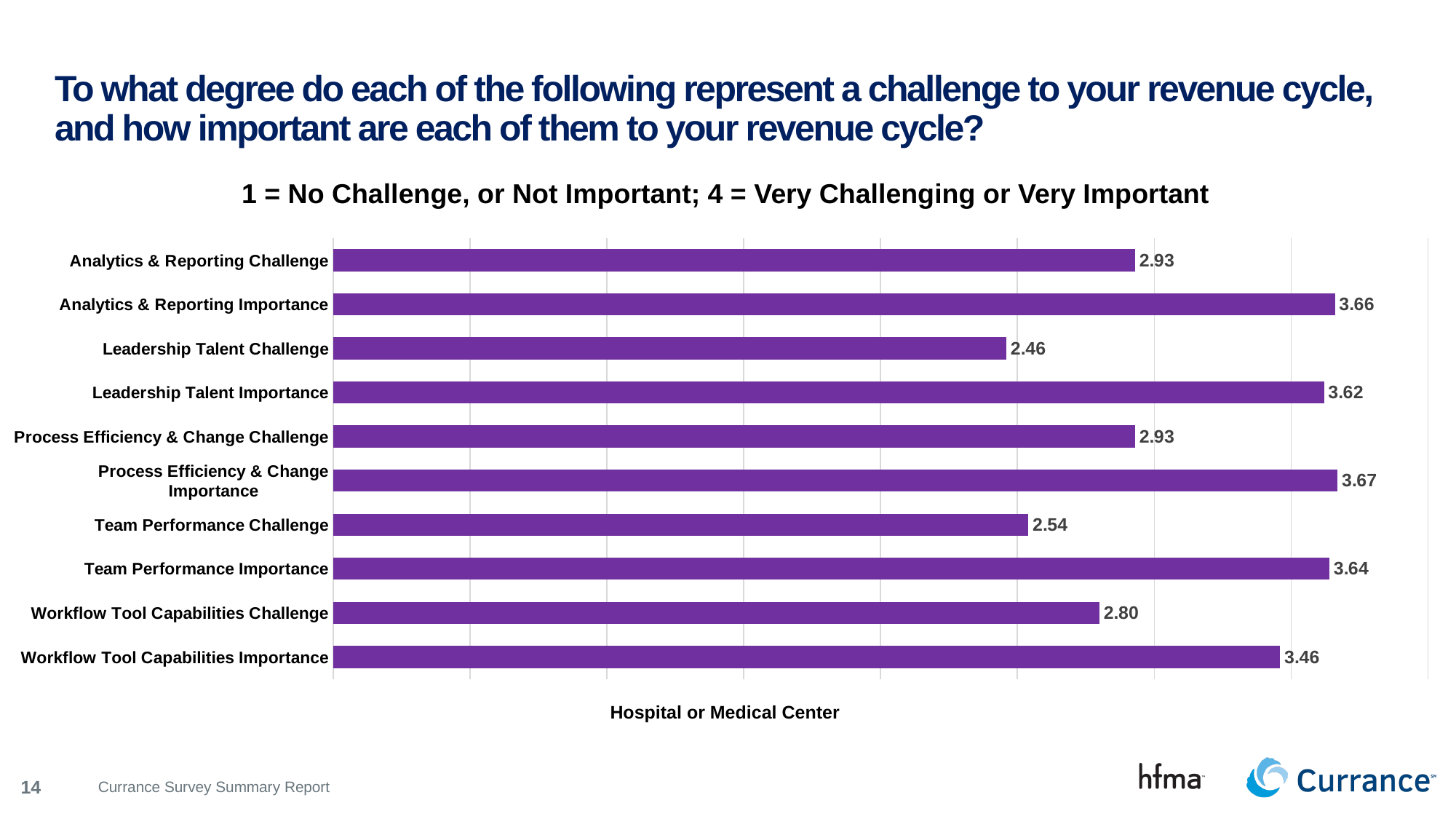
What is the value for Workflow Tool Capabilities Challenge? 2.80 Which category has the lowest value? Leadership Talent Challenge What is the difference between Analytics & Reporting Importance and Analytics & Reporting Challenge? 0.73 What is the value for Team Performance Importance? 3.64 What kind of chart is shown on the slide? Bar chart What is the value for Leadership Talent Challenge? 2.46 What is the difference between Team Performance Importance and Team Performance Challenge? 1.10 Which is larger, Workflow Tool Capabilities Importance or Leadership Talent Importance? Leadership Talent Importance How many categories are shown in the chart? 10 Which category has the highest value? Process Efficiency & Change Importance What is the label shown below the chart's horizontal axis? Hospital or Medical Center What is the value for Analytics & Reporting Importance? 3.66